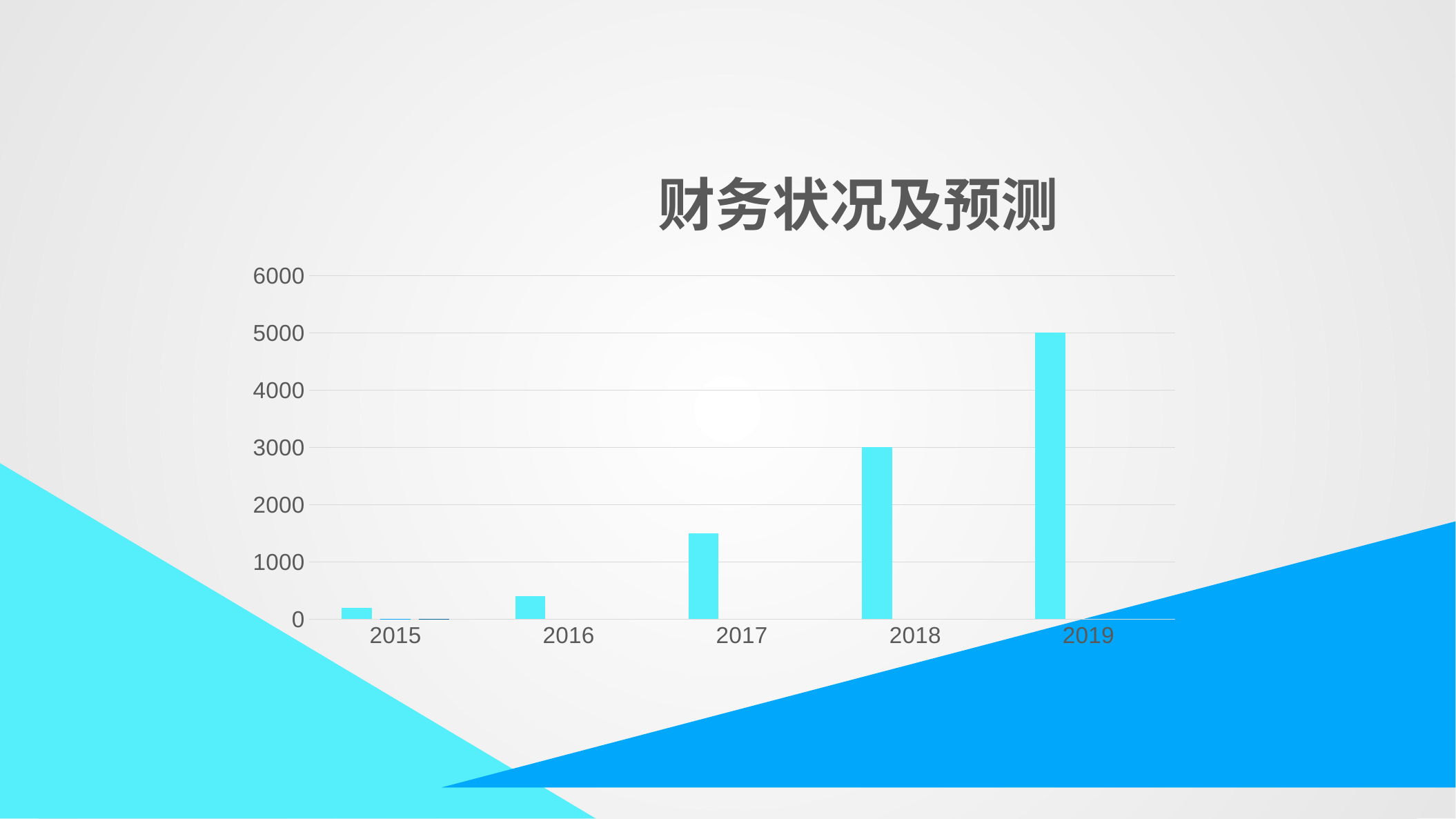
Is the value for 2017 greater or less than 1000? greater What kind of chart is shown on the slide? bar chart Which year has the highest bar? 2019 How many years are shown on the x axis of the chart? 5 Do the values rise or fall from 2015 to 2019? rise Is the value for 2016 greater or less than 1000? less Is the value for 2017 greater or less than 2000? less What is the value for 2019? 5000 What is the title of the chart? 财务状况及预测 Which is larger, the value for 2018 or the value for 2017? 2018 Which year has the lowest bar? 2015 What is the value for 2018? 3000